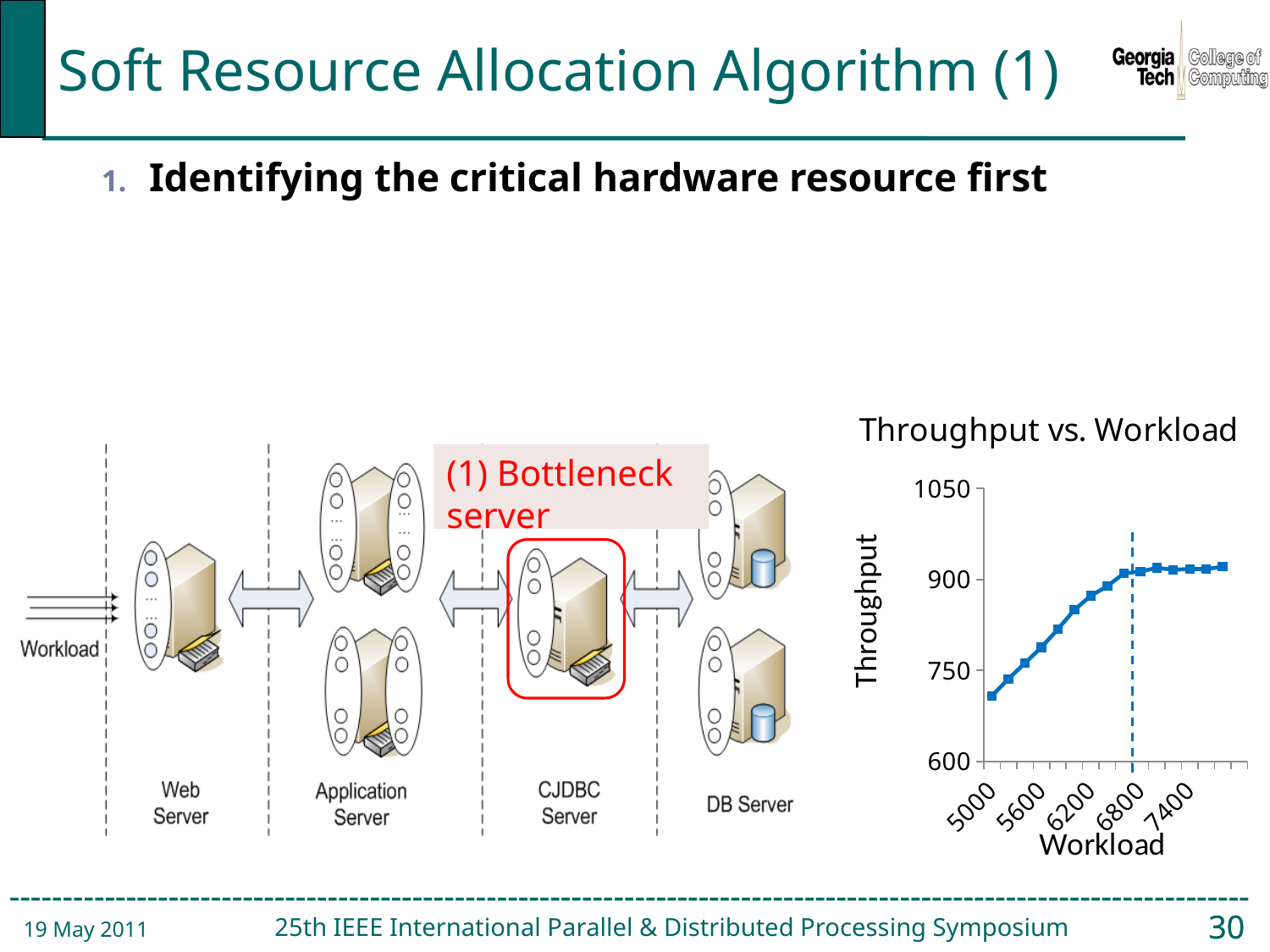
On the 'Throughput vs. Workload' chart, does throughput rise or fall as workload increases from 5000 to 6800? rise What kind of chart is the 'Throughput vs. Workload' chart? line chart On the 'Throughput vs. Workload' chart, is the throughput at workload 5000 greater or less than 750? less On the 'Throughput vs. Workload' chart, is the throughput at workload 6200 greater or less than 750? greater On the 'Throughput vs. Workload' chart, is the throughput at workload 7400 greater or less than 900? greater On the 'Throughput vs. Workload' chart, which workload has the lowest throughput? 5000 What is the label of the y axis on the 'Throughput vs. Workload' chart? Throughput What is the title of the chart on the right side of the slide? Throughput vs. Workload On the 'Throughput vs. Workload' chart, is throughput higher at workload 7400 or at workload 5000? 7400 On the 'Throughput vs. Workload' chart, is throughput higher at workload 5600 or at workload 6800? 6800